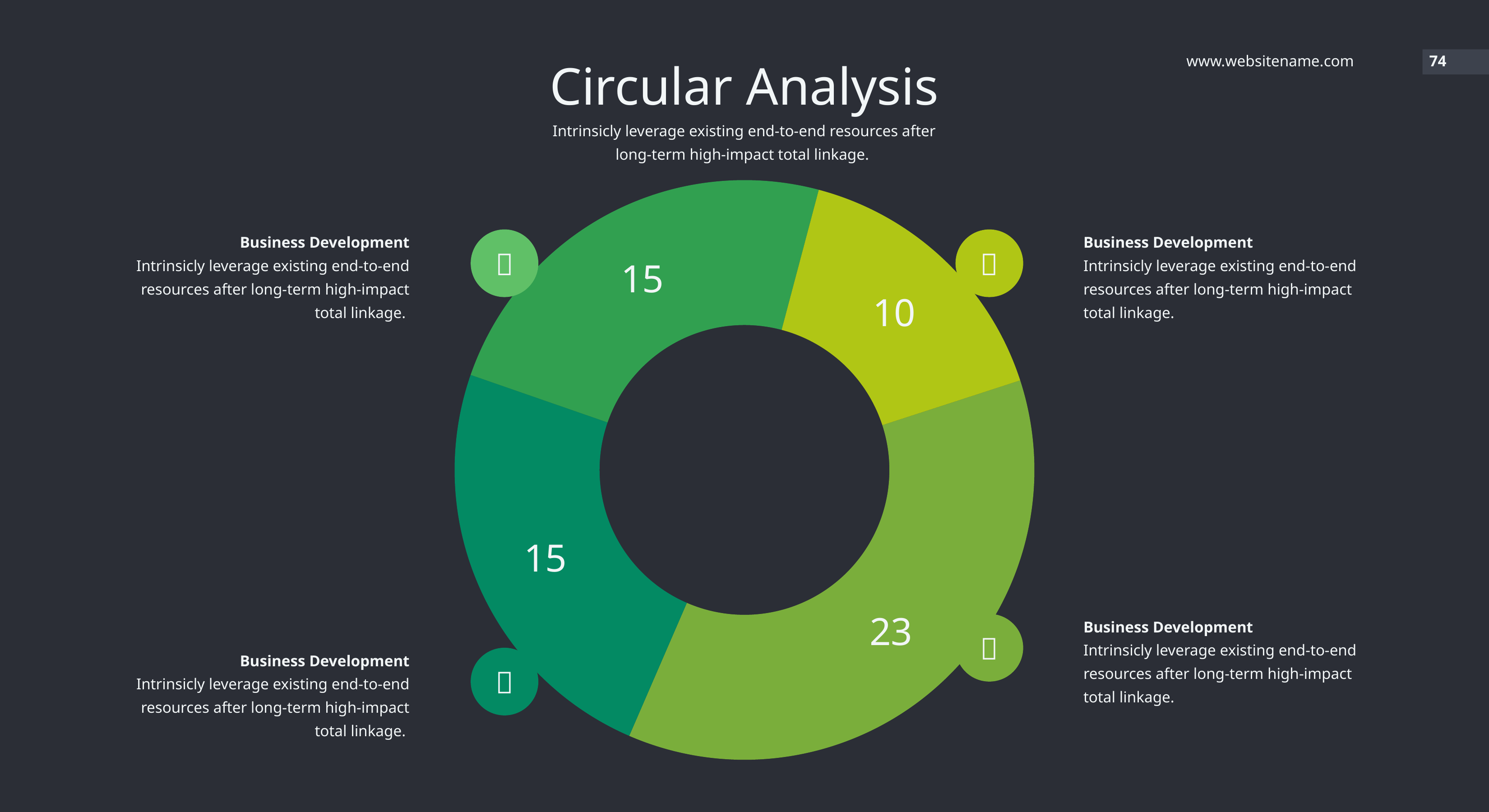
What value is shown on the light green segment at the bottom right of the donut chart? 23 What is the total of all four segment values on the donut chart? 63 Which is larger: the bottom-right segment value or the top-right segment value? The bottom-right segment (23) What kind of chart is shown on the slide? Donut (pie) chart What is the difference between the largest segment value (23) and the smallest segment value (10)? 13 What is the title of the chart on the slide? Circular Analysis What value is shown on the green segment at the top left of the donut chart? 15 What is the smallest value shown on the donut chart? 10 What value is shown on the yellow-green segment at the top right of the donut chart? 10 What is the largest value shown on the donut chart? 23 How many segments does the donut chart have? 4 What value is shown on the dark green segment on the left side of the donut chart? 15